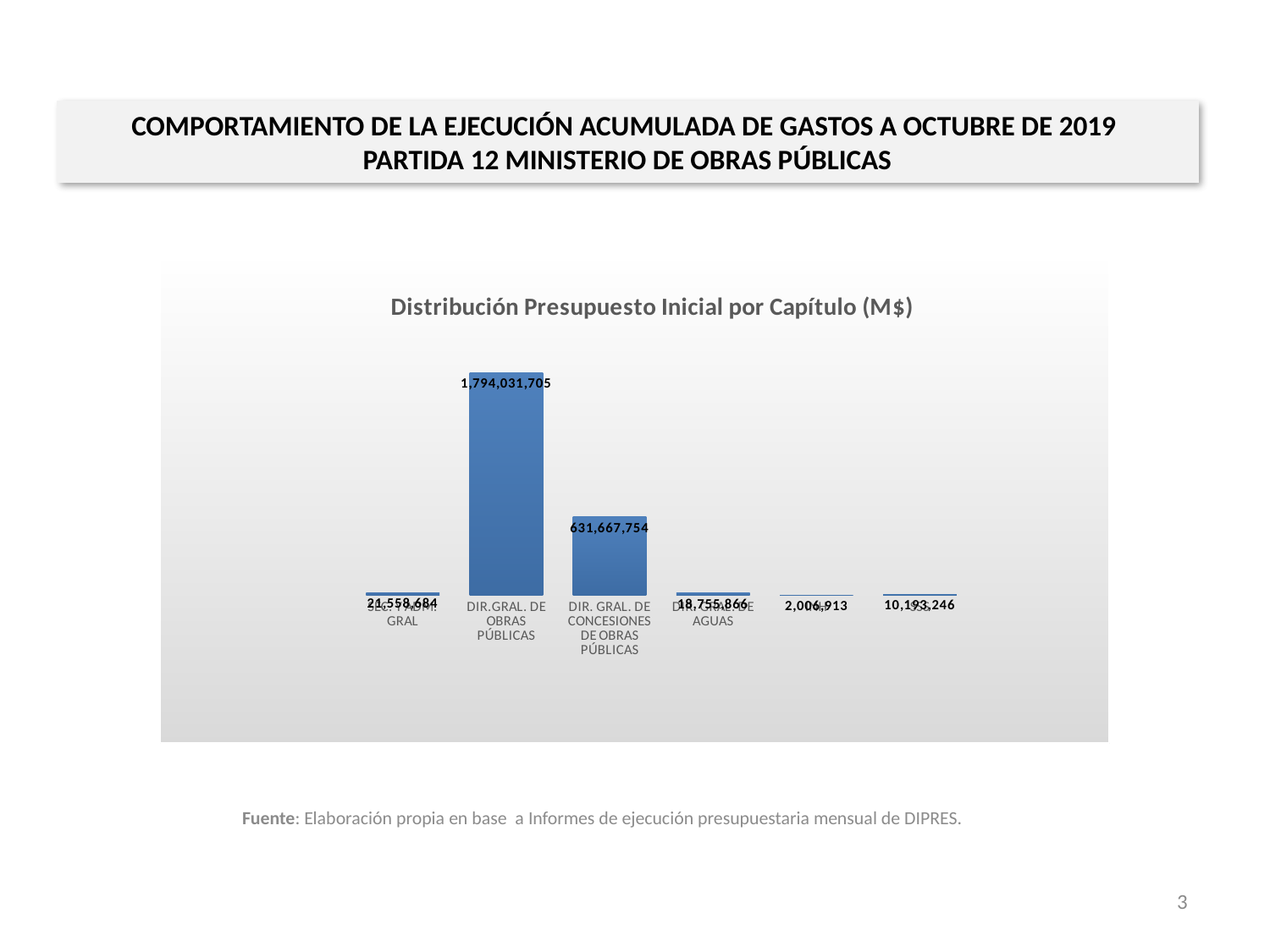
What is the value for DIR.GRAL. DE OBRAS PÚBLICAS? 1,794,031,705 What is the value for DIR. GRAL. DE CONCESIONES DE OBRAS PÚBLICAS? 631,667,754 What colour are the bars in the chart? blue How many bars are plotted in the chart? 6 What is the difference between the values for DIR. GRAL. DE CONCESIONES DE OBRAS PÚBLICAS and DIR. GRAL. DE AGUAS? 612,911,888 What is the difference between the values for DIR.GRAL. DE OBRAS PÚBLICAS and DIR. GRAL. DE CONCESIONES DE OBRAS PÚBLICAS? 1,162,363,951 What type of chart is shown on the slide? bar chart What is the title of the chart? Distribución Presupuesto Inicial por Capítulo (M$) What is the smallest value labelled on the chart? 2,006,913 Which is larger, the value for DIR. GRAL. DE CONCESIONES DE OBRAS PÚBLICAS or the value for DIR. GRAL. DE AGUAS? DIR. GRAL. DE CONCESIONES DE OBRAS PÚBLICAS What is the value for DIR. GRAL. DE AGUAS? 18,755,866 Which category has the highest value? DIR.GRAL. DE OBRAS PÚBLICAS